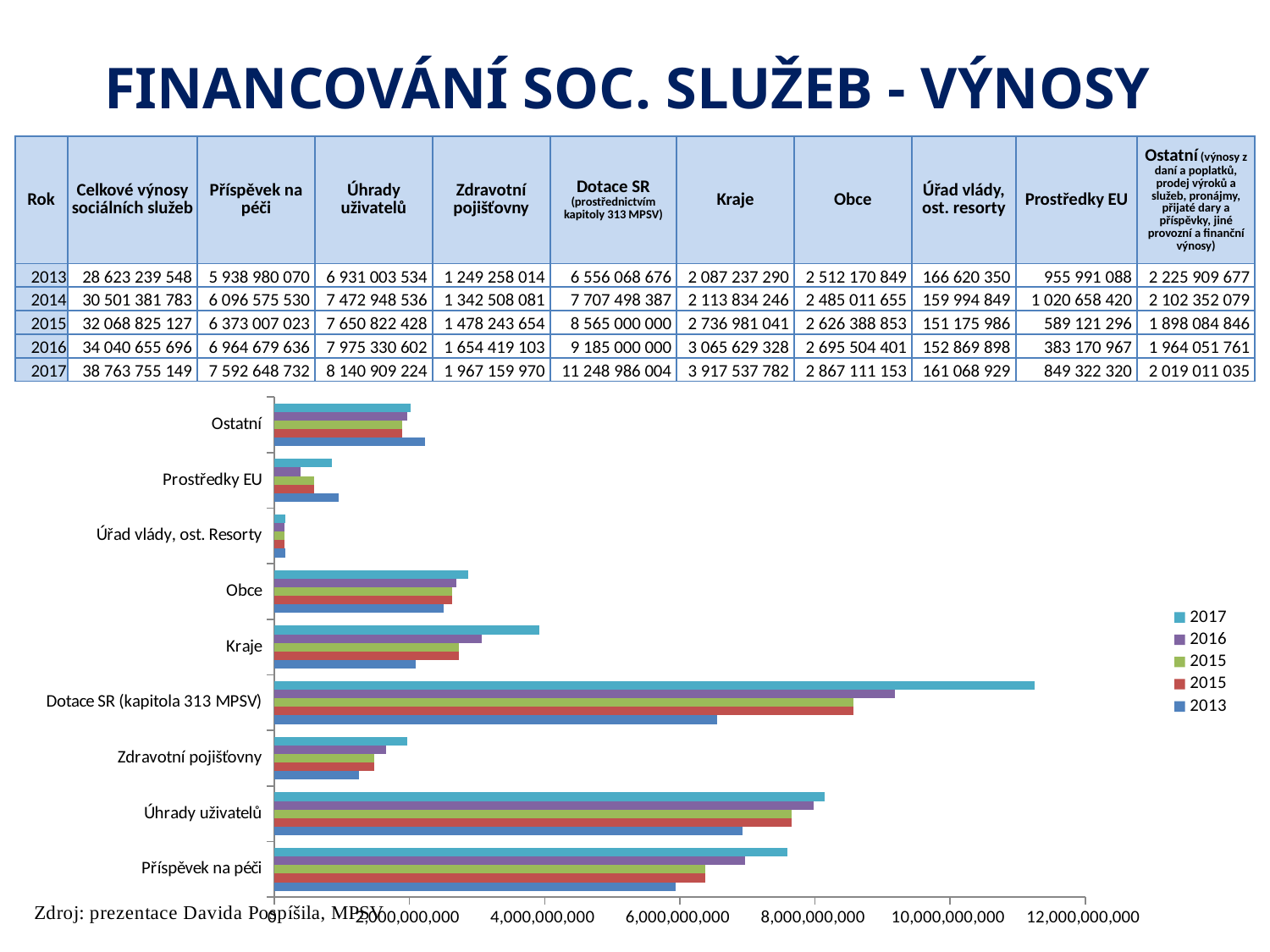
How many categories are plotted on the vertical axis of the bar chart? 9 How many series does the legend of the bar chart list? 5 According to the table, what is the value of Dotace SR for 2017? 11 248 986 004 In the bar chart, is the 2017 value for Obce greater or less than 2,000,000,000? greater In the bar chart, is the 2017 value for Dotace SR (kapitola 313 MPSV) greater or less than 10,000,000,000? greater What kind of chart is shown below the table on the slide? bar chart In the bar chart, which is larger for 2017: Kraje or Obce? Kraje Do the bars for Dotace SR (kapitola 313 MPSV) rise or fall from 2013 to 2017? rise Which category has the shortest bars in the bar chart? Úřad vlády, ost. Resorty Which year label appears twice in the legend of the bar chart? 2015 In the bar chart, is the 2013 value for Prostředky EU greater or less than 2,000,000,000? less Which category has the longest bar for 2017 in the bar chart? Dotace SR (kapitola 313 MPSV)